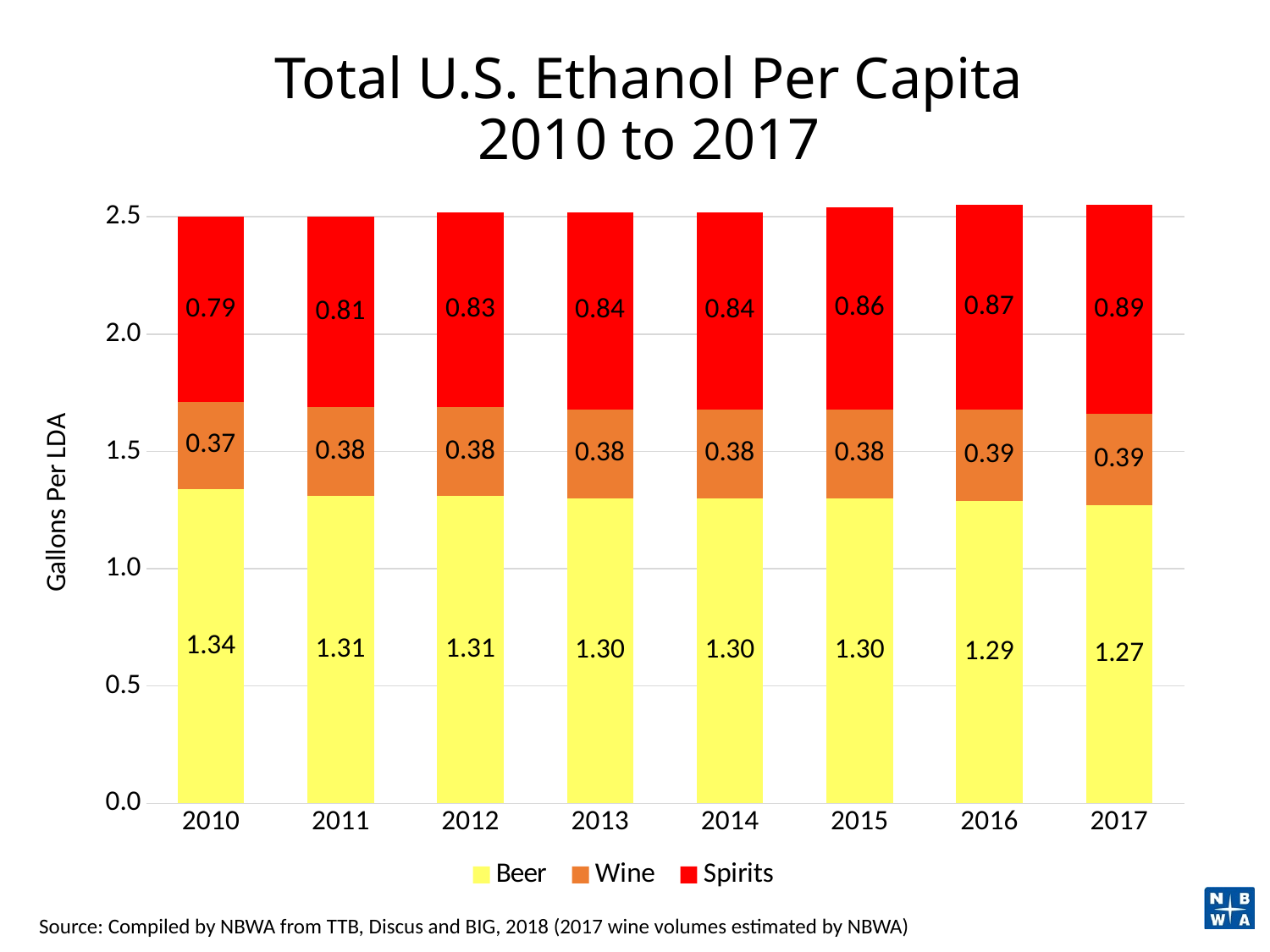
What kind of chart is shown on the slide? Stacked bar chart How many series does the legend list? 3 What is the Spirits value for 2017? 0.89 Do the Spirits values rise or fall from 2010 to 2017? Rise What is the difference between the Spirits value in 2017 and in 2010? 0.10 How many years are shown on the x axis? 8 In which year is the Spirits value lowest? 2010 In which year is the Beer value highest? 2010 What is the total of the stacked bar for 2010? 2.50 Which is larger, the Beer value in 2011 or the Beer value in 2017? 2011 What is the Beer value for 2010? 1.34 What is the Wine value for 2014? 0.38